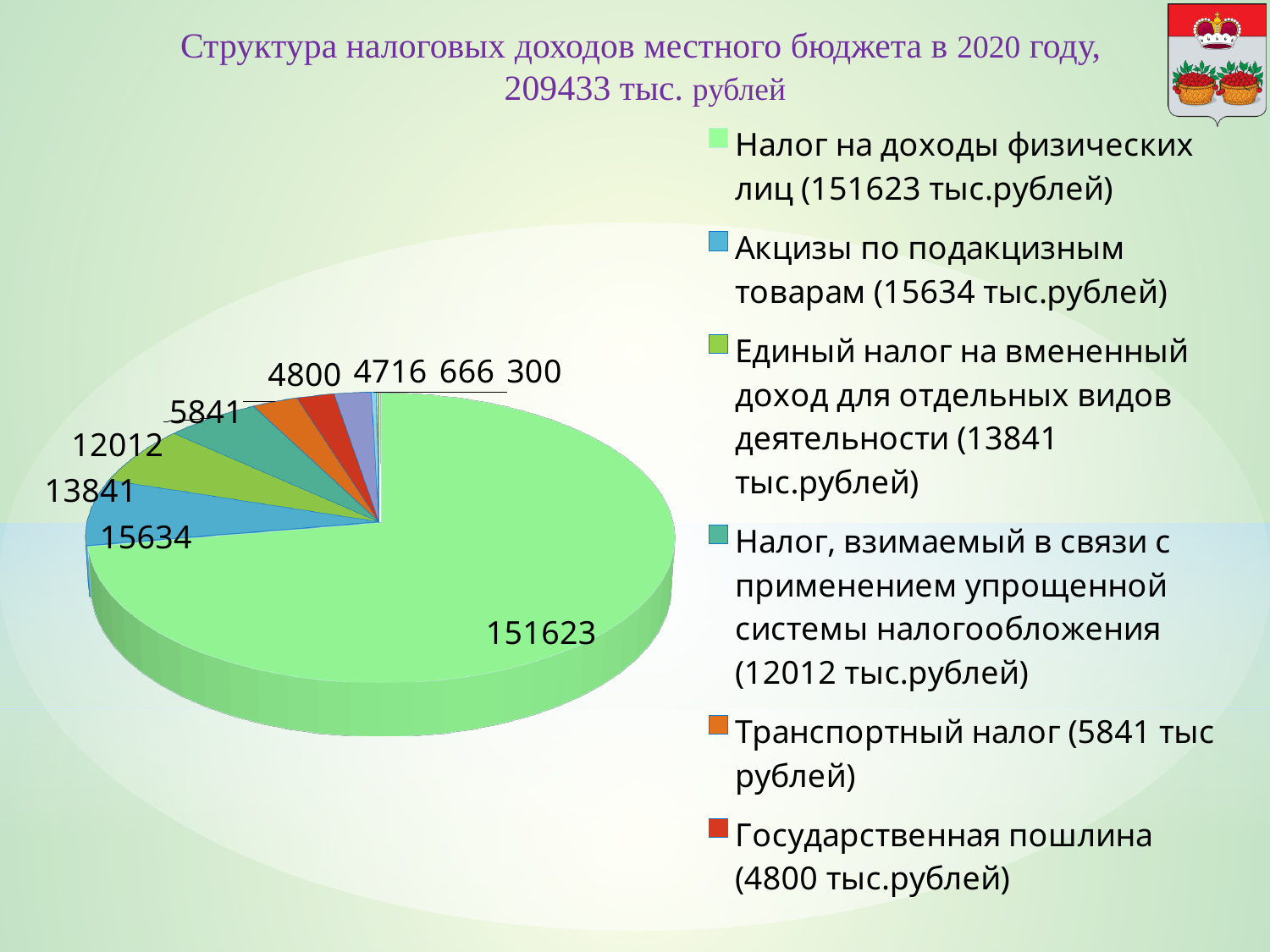
How many slices are labelled with values on the pie chart? 9 What is the difference between Акцизы по подакцизным товарам and Единый налог на вмененный доход? 1793 What total amount is stated in the chart title? 209433 тыс. рублей Which category has the largest slice of the pie? Налог на доходы физических лиц What is the value for Налог на доходы физических лиц? 151623 What is the difference between Транспортный налог and Государственная пошлина? 1041 How many entries does the legend list? 6 What is the value for Государственная пошлина? 4800 Which is larger: Акцизы по подакцизным товарам or Налог, взимаемый в связи с применением упрощенной системы налогообложения? Акцизы по подакцизным товарам What is the value for Транспортный налог? 5841 What kind of chart is shown on the slide? pie chart What is the smallest value labelled on the pie chart? 300